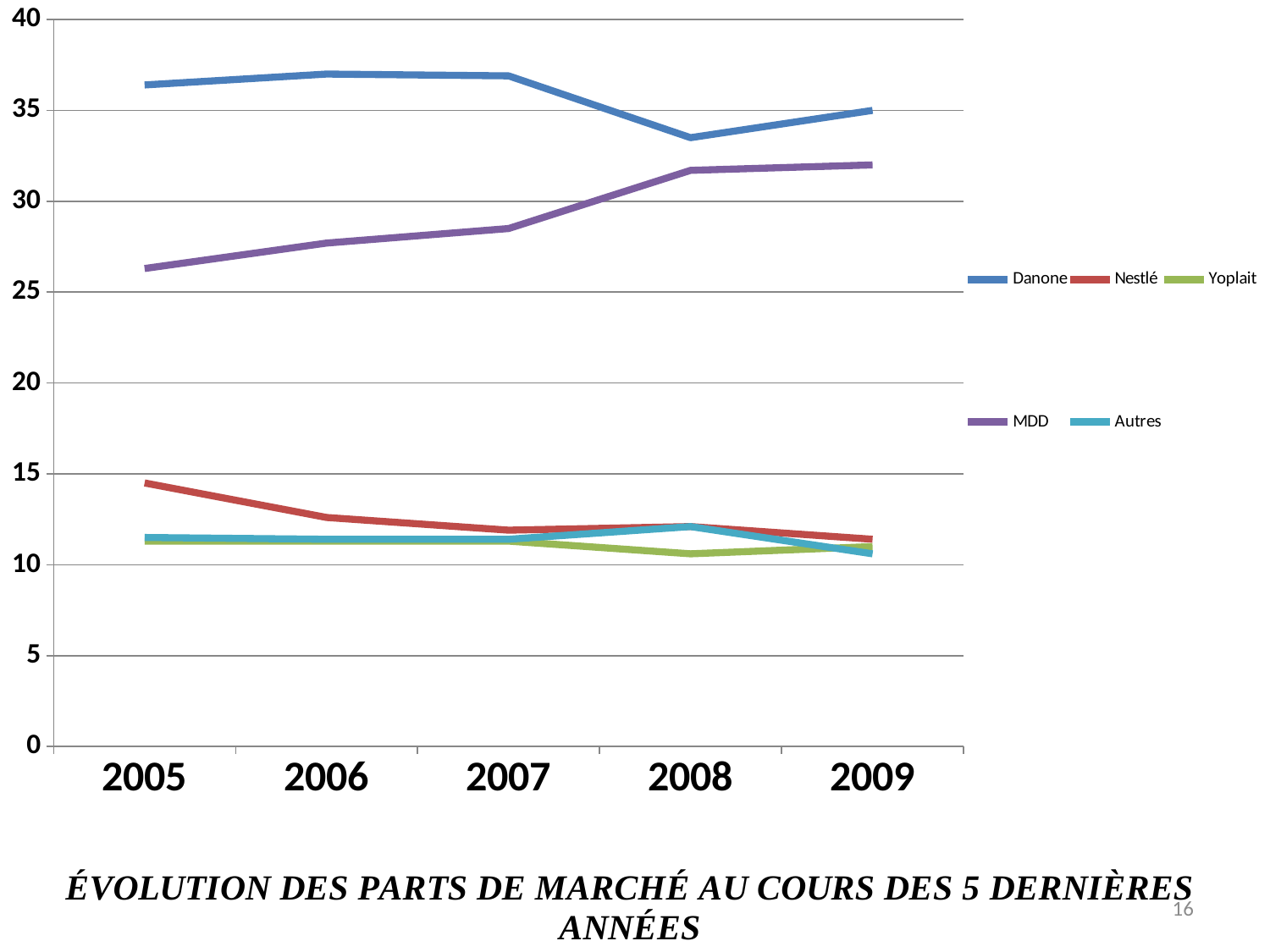
In 2007, which is larger: the value for Danone or the value for MDD? Danone How many years are shown along the x axis? 5 How many series does the legend list? 5 For Nestlé, which is larger: the value in 2005 or the value in 2009? 2005 Is the value for Danone in 2008 greater or less than 35? less What is the title shown below the chart? ÉVOLUTION DES PARTS DE MARCHÉ AU COURS DES 5 DERNIÈRES ANNÉES Is the value for MDD in 2009 greater or less than 30? greater Which series has the lowest value in 2008? Yoplait Does the MDD line rise or fall from 2005 to 2009? rise Is the value for MDD in 2005 greater or less than 25? greater What kind of chart is shown on the slide? line chart Which series has the highest market share in 2005? Danone